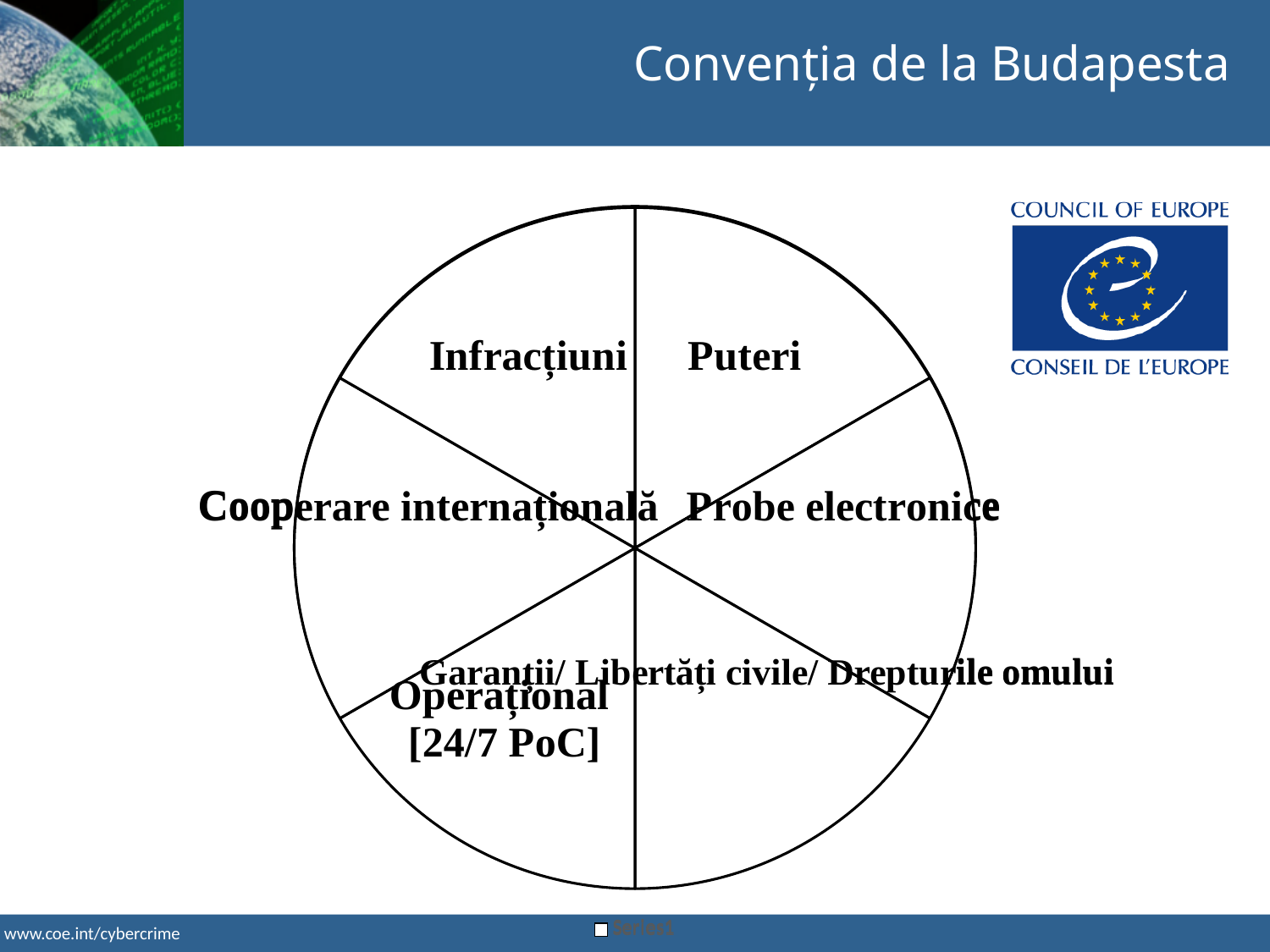
How many slices does the pie chart have? 6 What kind of chart is shown on the slide? pie chart What is the name of the series shown in the legend of the pie chart? Series1 Are the slices of the pie chart equal in size or different in size? equal How many series does the legend of the pie chart list? 1 What is the title of the slide containing the pie chart? Convenția de la Budapesta